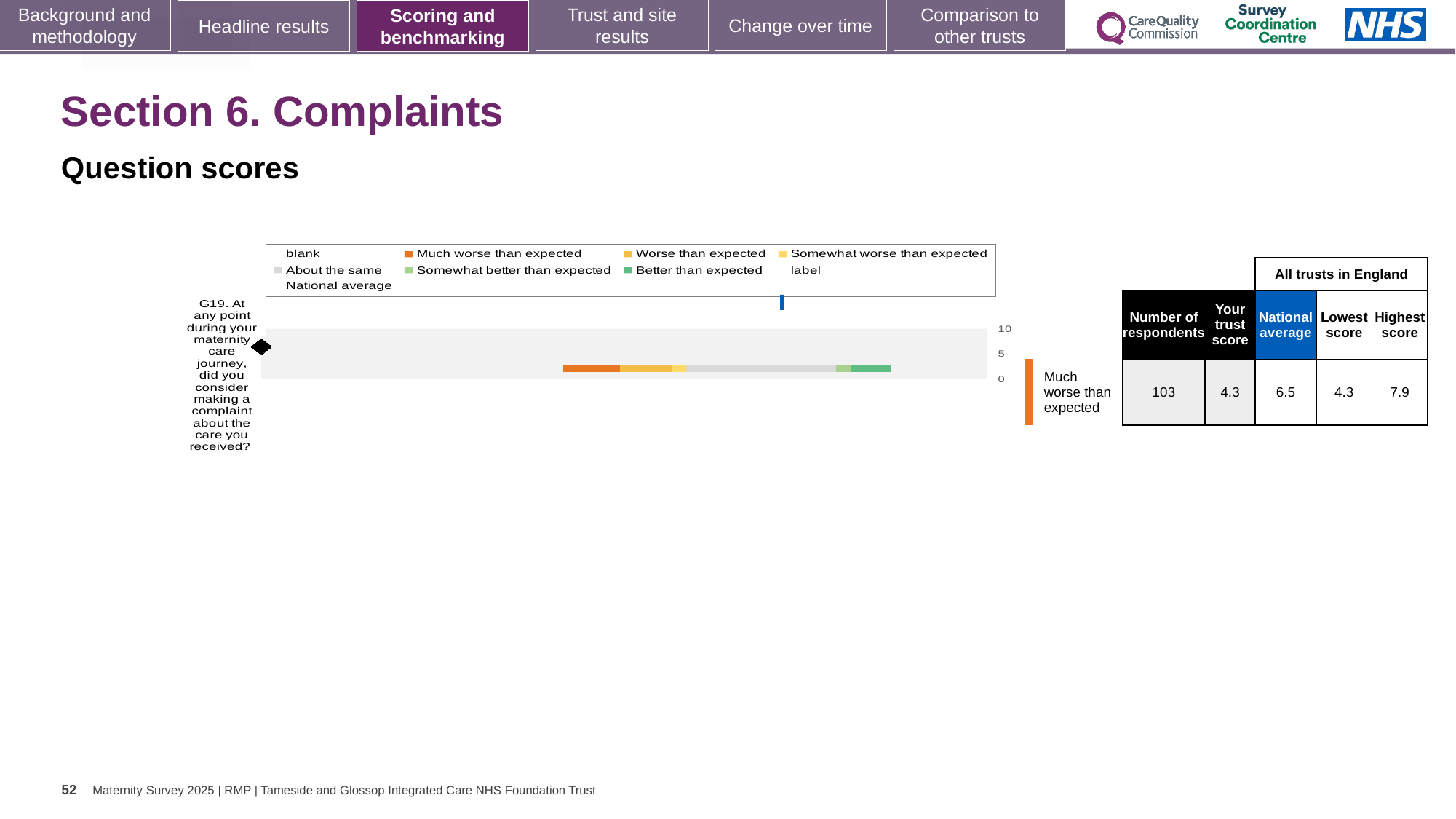
How many questions (categories) are plotted in the chart? 1 Is the trust's score for question G19 greater or less than 5 on the chart axis? less What is the highest tick value shown on the chart's axis? 10 What is the lowest score among all trusts in England for question G19? 4.3 How many respondents answered question G19? 103 Which is larger for question G19: the trust's score or the national average? the national average What is the highest score among all trusts in England for question G19? 7.9 Which benchmark category is the trust's result for question G19 placed in? Much worse than expected What is the difference between the highest and lowest trust scores for question G19? 3.6 What kind of chart is shown on the slide? bar chart What is the national average score for question G19? 6.5 What is the trust's score for question G19 about considering making a complaint? 4.3